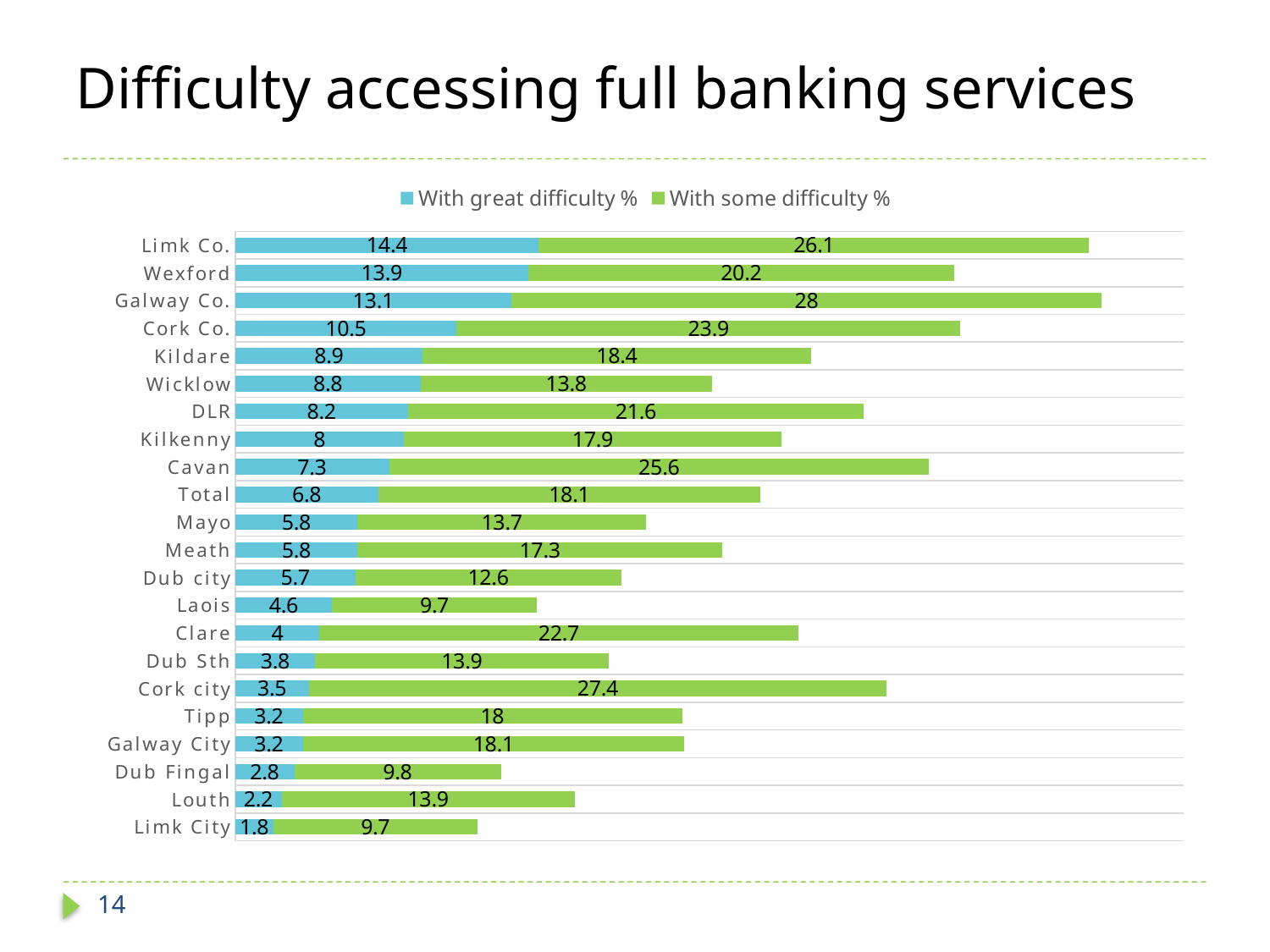
What is the 'With great difficulty %' value for Limk Co.? 14.4 Which category has the highest 'With great difficulty %' value? Limk Co. Which has a larger 'With some difficulty %' value, Clare or Wicklow? Clare What is the 'With some difficulty %' value for Cork city? 27.4 How many categories are shown on the chart? 22 Which category has the lowest 'With great difficulty %' value? Limk City What kind of chart is shown on the slide? Stacked bar chart What is the 'With some difficulty %' value for Total? 18.1 What is the difference between the 'With some difficulty %' values for Cavan and Kildare? 7.2 How many series does the legend list? 2 Which category has the highest 'With some difficulty %' value? Galway Co. What is the total of the stacked bar for Galway Co.? 41.1